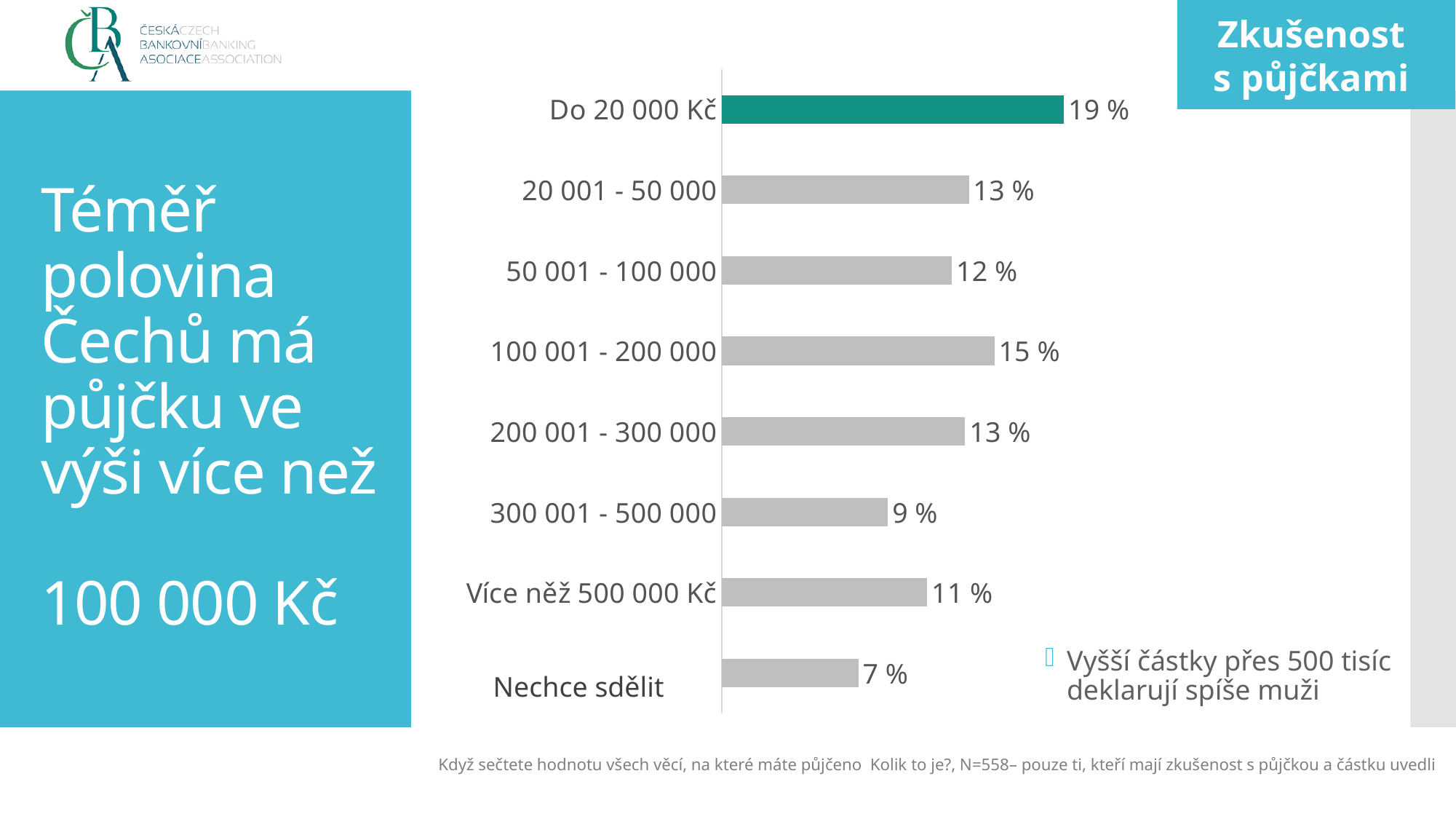
What is the value for the category "100 001 - 200 000"? 15 % What is the difference between the values for "Do 20 000 Kč" and "300 001 - 500 000"? 10 % What kind of chart is shown on the slide? bar chart Which bar is coloured differently (green) from the other grey bars? Do 20 000 Kč Which is larger, the value for "100 001 - 200 000" or the value for "50 001 - 100 000"? 100 001 - 200 000 Which category has the lowest value? Nechce sdělit What is the value for the category "Do 20 000 Kč"? 19 % What is the value for the category "Více něž 500 000 Kč"? 11 % What is the value for the category "Nechce sdělit"? 7 % How many categories are shown in the chart? 8 What is the difference between the values for "20 001 - 50 000" and "200 001 - 300 000"? 0 % Which category has the highest value? Do 20 000 Kč